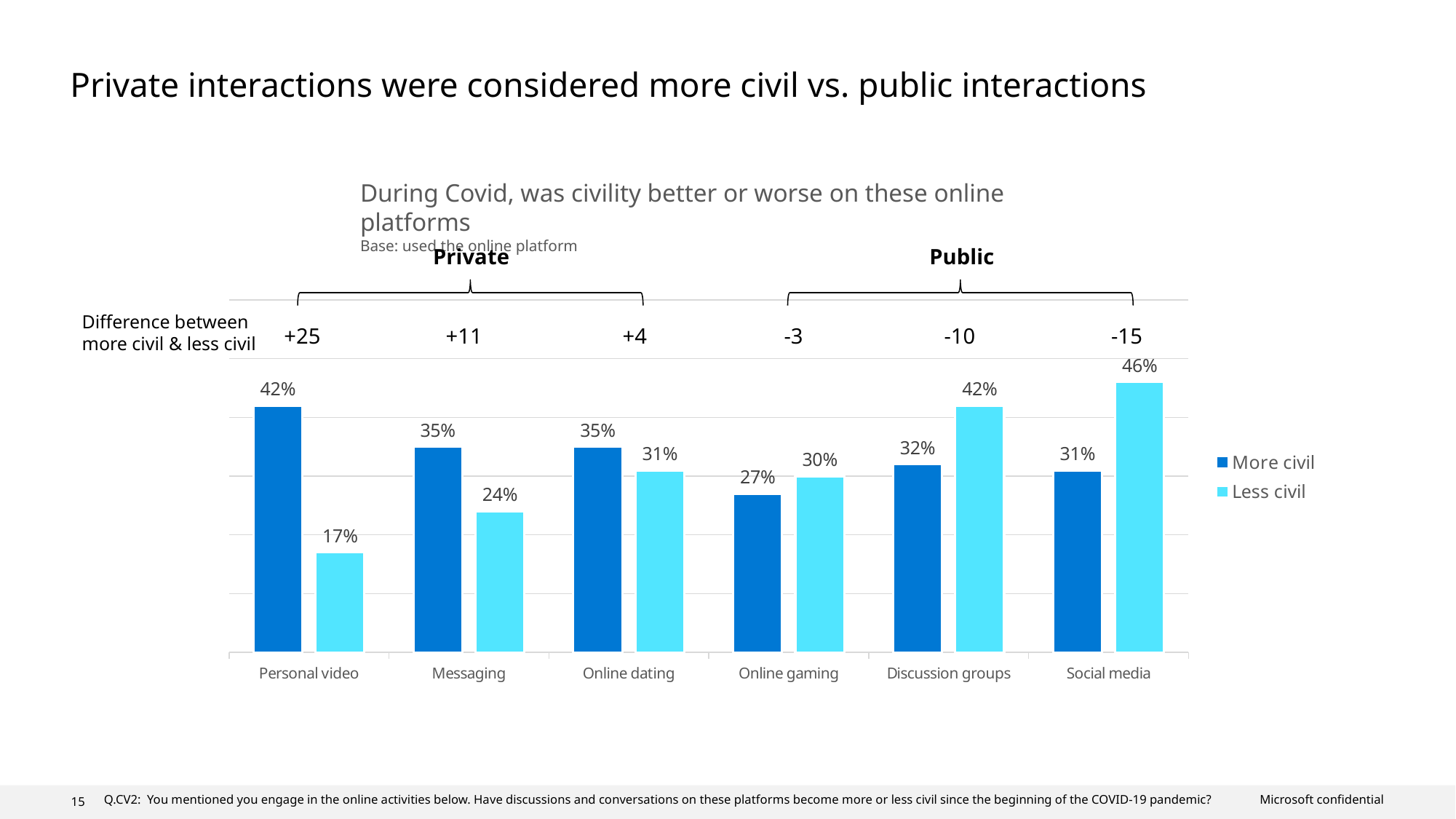
Which platform has the lowest 'More civil' value? Online gaming What percentage said Social media was less civil? 46% How many platforms are shown on the x axis? 6 What is the 'Less civil' value for Messaging? 24% What percentage said Personal video was more civil? 42% Which platforms are grouped under the 'Public' bracket? Online gaming, Discussion groups, Social media Which platform has the lowest 'Less civil' value? Personal video How many series does the legend list? 2 What kind of chart is shown on the slide? Bar chart For Online dating, which is larger: the 'More civil' value or the 'Less civil' value? More civil Which platform has the highest 'Less civil' value? Social media What is the difference between the 'More civil' and 'Less civil' values for Discussion groups? 10